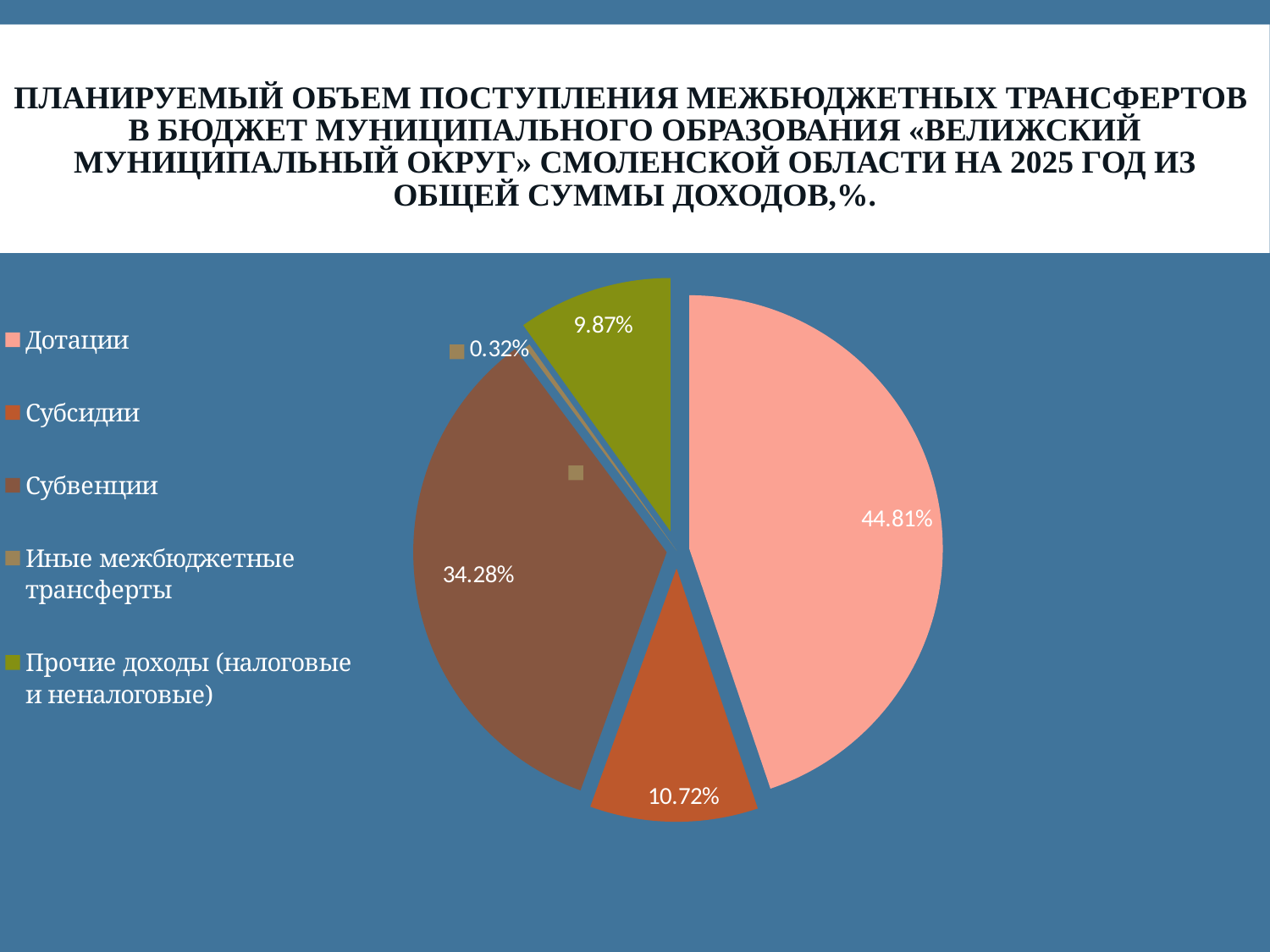
How many categories does the pie chart show? 5 What is the difference in percentage points between Дотации and Субвенции? 10.53 What is the value for Иные межбюджетные трансферты? 0.32% Which is larger, Субсидии or Прочие доходы (налоговые и неналоговые)? Субсидии What percentage is shown for Субсидии? 10.72% What is the difference in percentage points between Субсидии and Прочие доходы (налоговые и неналоговые)? 0.85 Which category has the smallest slice of the pie? Иные межбюджетные трансферты What is the value shown for Субвенции? 34.28% What type of chart is shown on the slide? Pie chart What share of the pie does Дотации account for? 44.81% Which category has the largest slice of the pie? Дотации What share is shown for Прочие доходы (налоговые и неналоговые)? 9.87%